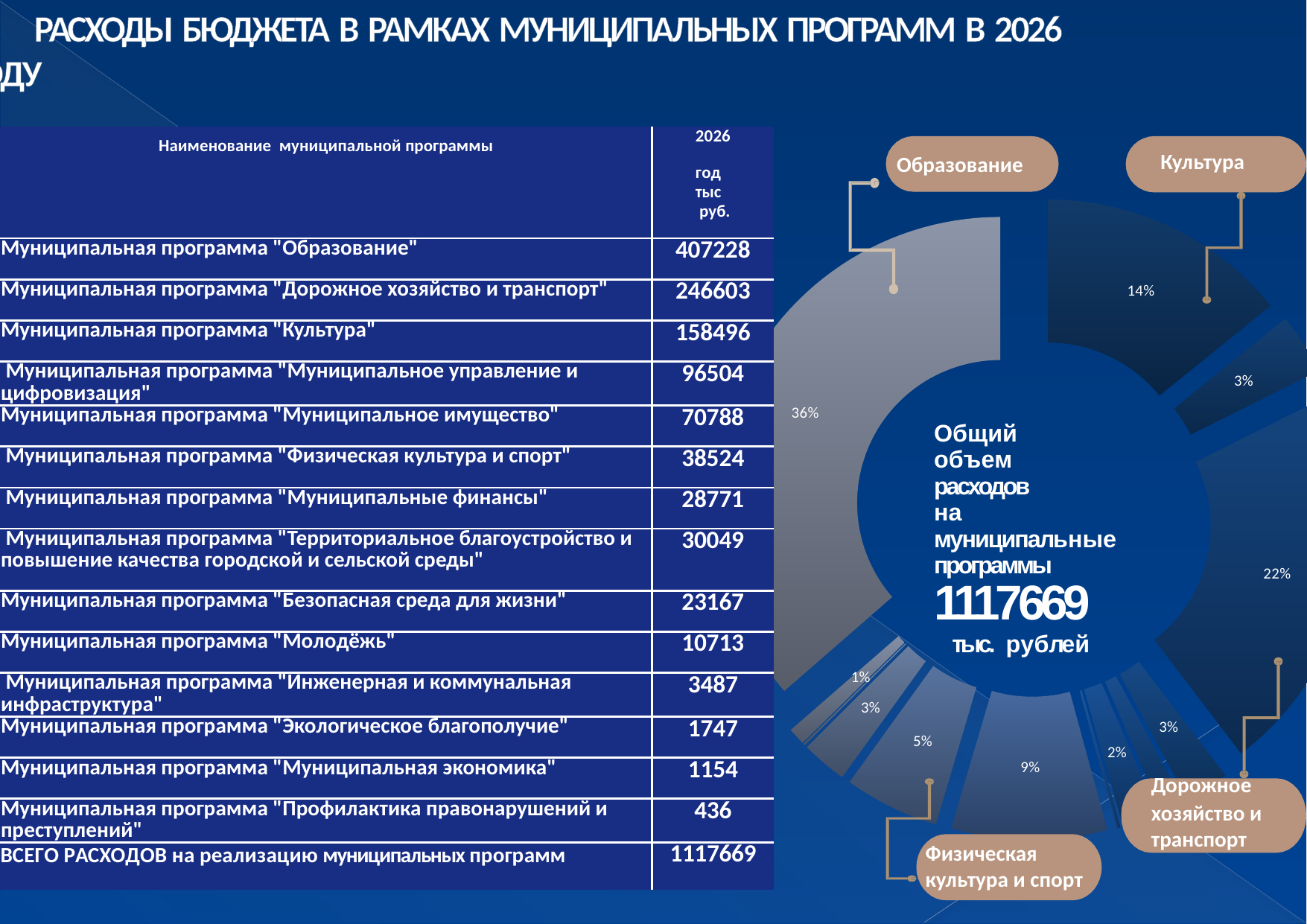
In the pie chart, by how many percentage points does the Образование share exceed the Дорожное хозяйство и транспорт share? 14 percentage points What kind of chart is shown on the right side of the slide? doughnut chart In the pie chart, which slice is larger: Образование or Культура? Образование What is the largest percentage label shown on the pie chart? 36% In the pie chart, what share is shown for Образование? 36% What total value is printed in the centre of the pie chart? 1117669 тыс. рублей In the pie chart, what share is shown for Культура? 14% Which labelled program has the largest slice in the pie chart? Образование In the pie chart, which slice is larger: Культура or Дорожное хозяйство и транспорт? Дорожное хозяйство и транспорт In the pie chart, by how many percentage points does the Образование share exceed the Культура share? 22 percentage points In the pie chart, what share is shown for Дорожное хозяйство и транспорт? 22% What is the smallest percentage label shown on the pie chart? 1%